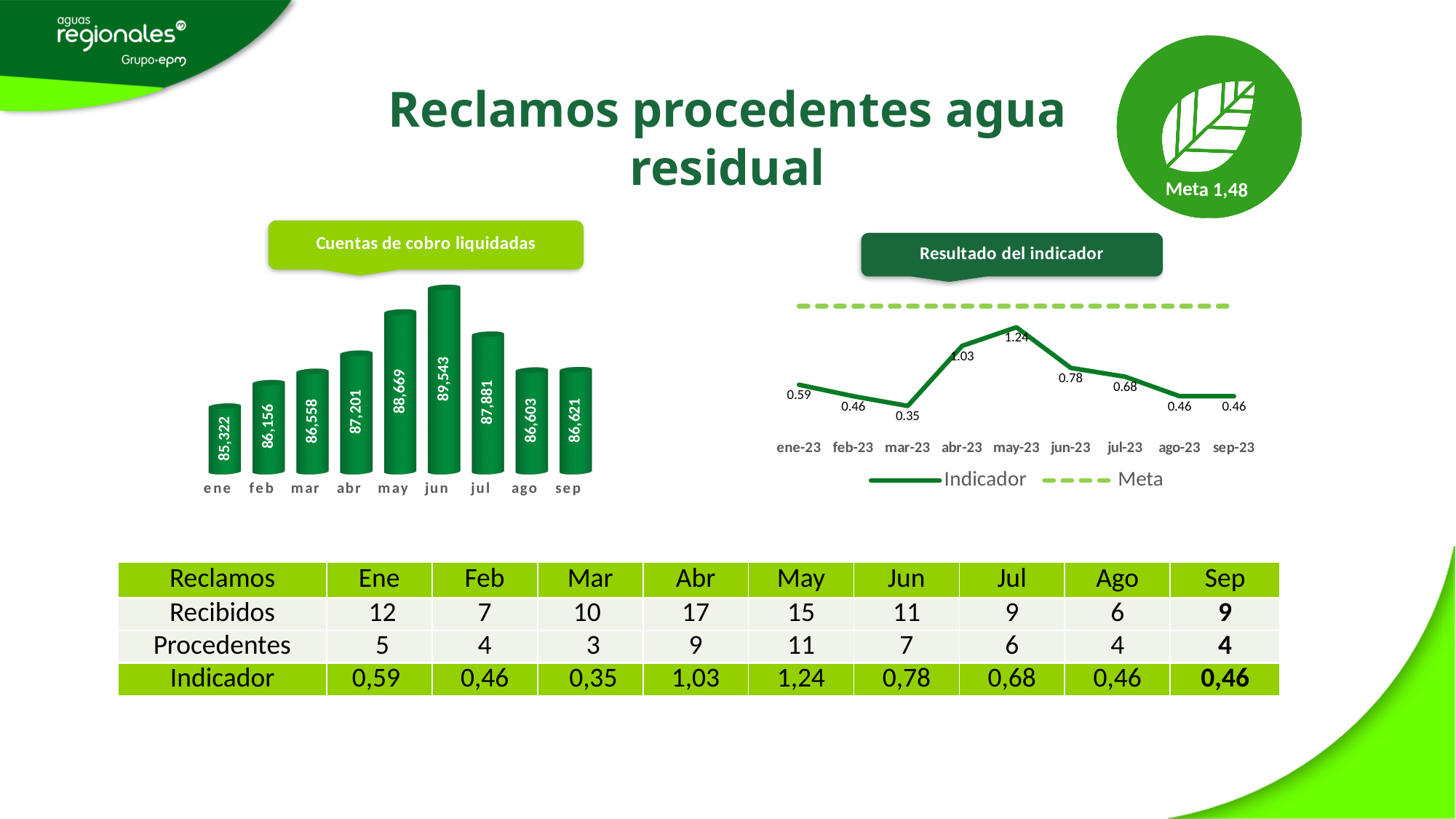
In the 'Cuentas de cobro liquidadas' chart, what is the value for jun? 89,543 In the 'Resultado del indicador' chart, is the Indicador value for abr-23 larger or smaller than the value for jun-23? Larger In the 'Cuentas de cobro liquidadas' chart, what is the difference between the values for jun and may? 874 In the 'Resultado del indicador' chart, what is the value for may-23? 1.24 In the 'Cuentas de cobro liquidadas' chart, which month has the lowest value? ene In the 'Cuentas de cobro liquidadas' chart, which month has the highest value? jun What kind of chart is 'Cuentas de cobro liquidadas'? Bar chart How many series does the legend of the 'Resultado del indicador' chart list? 2 In the 'Resultado del indicador' chart, which month has the lowest Indicador value? mar-23 In the 'Cuentas de cobro liquidadas' chart, how many months are shown? 9 In the 'Cuentas de cobro liquidadas' chart, what is the value for ene? 85,322 In the 'Resultado del indicador' chart, does the Indicador line rise or fall from may-23 to sep-23? Fall